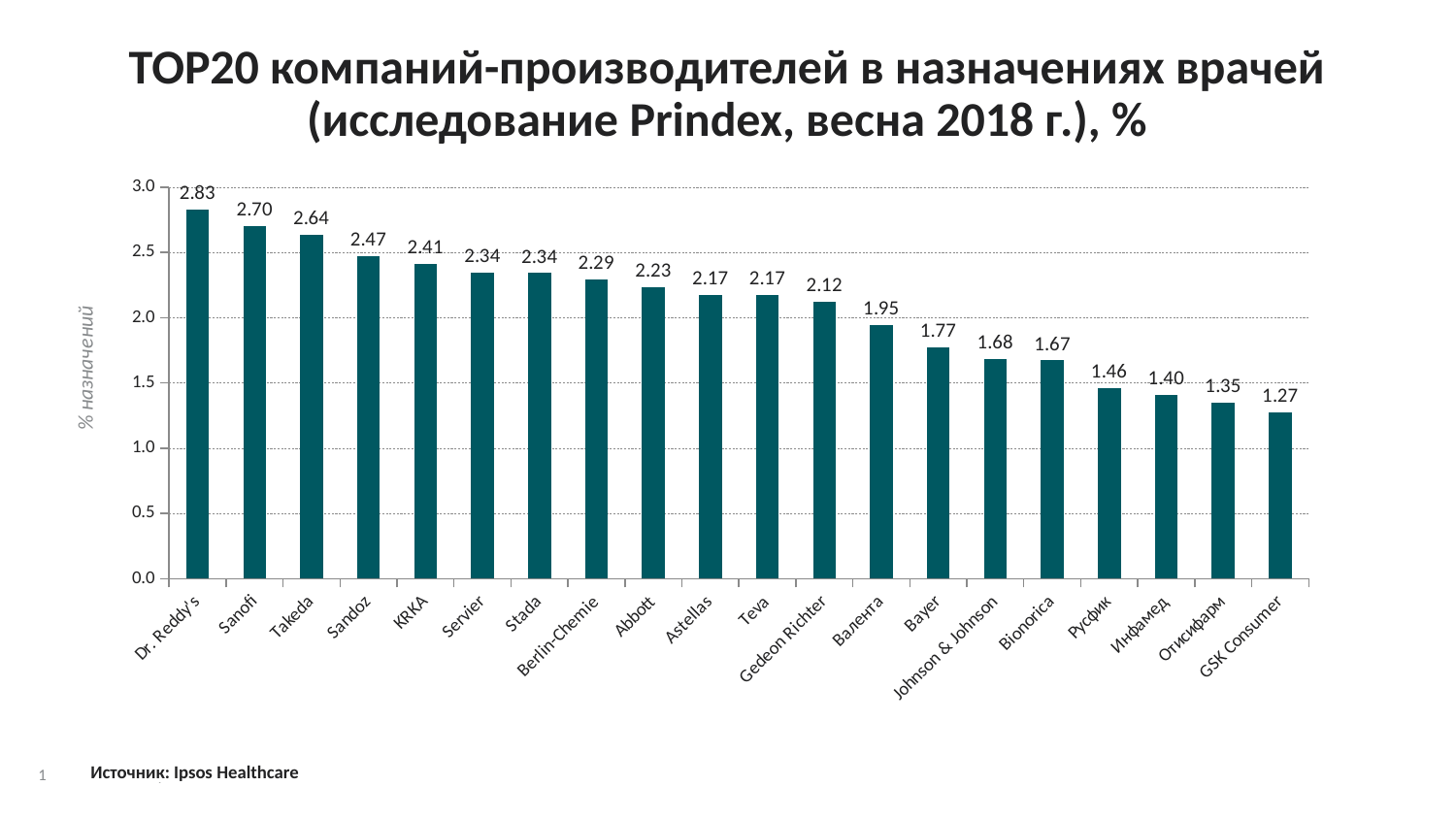
Which company has the lowest value? GSK Consumer Which is larger, the value for Sandoz or the value for Abbott? Sandoz Is the value for Валента greater or less than 2.0? less Which company has the highest value? Dr. Reddy's What is the difference between the values for Sanofi and Bayer? 0.93 What is the value for Johnson & Johnson? 1.68 How many companies are shown on the chart? 20 What is the value for Gedeon Richter? 2.12 What is the label of the vertical axis? % назначений What is the value for Dr. Reddy's? 2.83 What kind of chart is shown on the slide? bar chart Do the values rise or fall from left to right along the x axis? fall